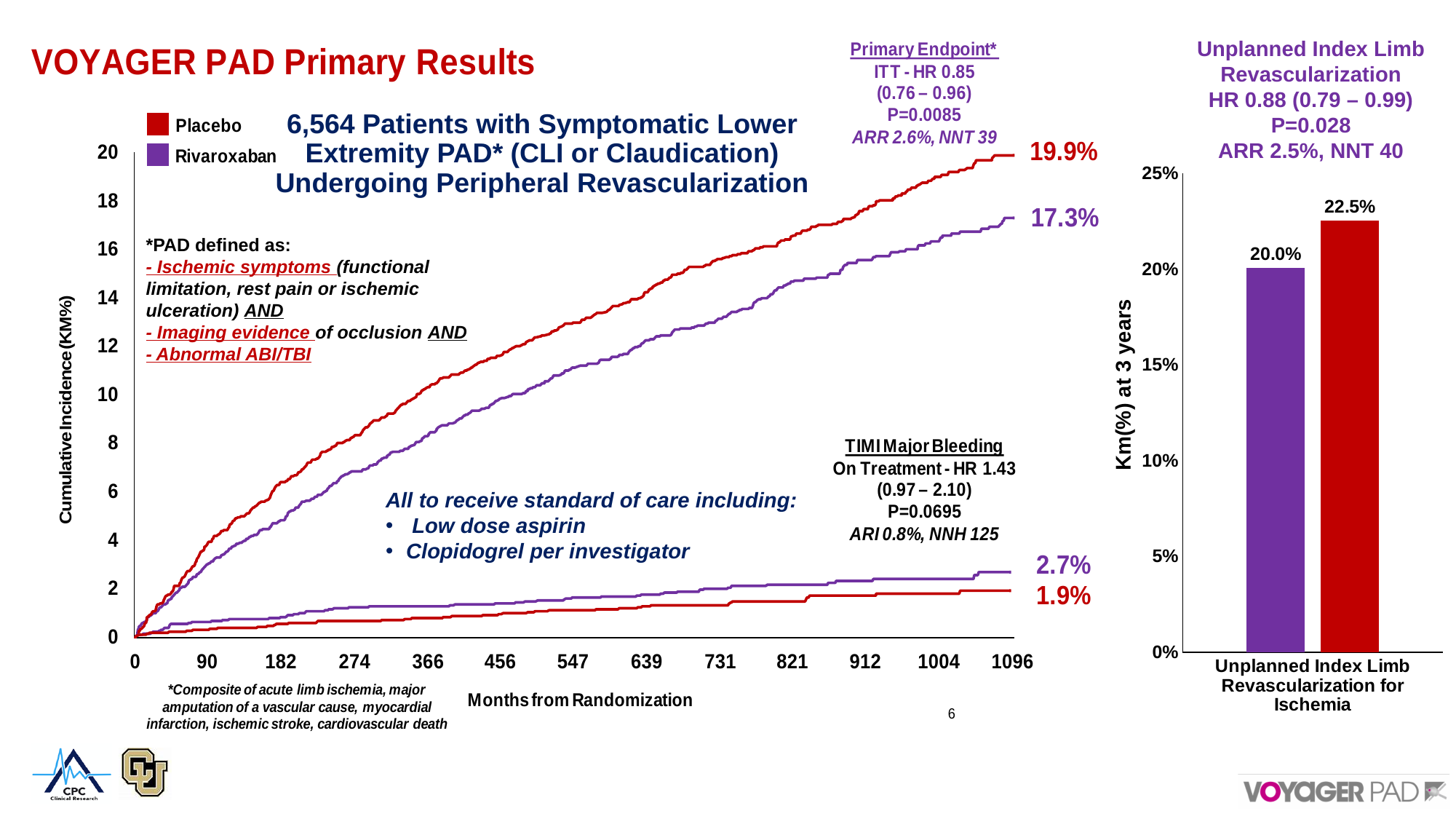
In the Kaplan-Meier chart on the left, what is the final cumulative incidence of the primary endpoint for Placebo? 19.9% In the Kaplan-Meier chart on the left, what is the difference between the final primary endpoint values for Placebo and Rivaroxaban? 2.6% What kind of chart is the Unplanned Index Limb Revascularization chart on the right? Bar chart In the Unplanned Index Limb Revascularization chart on the right, what is the KM% at 3 years for the Rivaroxaban (purple) bar? 20.0% In the Kaplan-Meier chart on the left, do the primary endpoint curves rise or fall over time from randomization? rise In the Kaplan-Meier chart on the left, which group has the higher final TIMI major bleeding value, Placebo or Rivaroxaban? Rivaroxaban In the Unplanned Index Limb Revascularization chart on the right, what is the KM% at 3 years for the Placebo (red) bar? 22.5% In the Kaplan-Meier chart on the left, how many series does the legend list? 2 In the Kaplan-Meier chart on the left, what is the final TIMI major bleeding value for Rivaroxaban? 2.7% In the Kaplan-Meier chart on the left, what is the final cumulative incidence of the primary endpoint for Rivaroxaban? 17.3% In the Kaplan-Meier chart on the left, what colour represents Placebo? Red In the Unplanned Index Limb Revascularization chart on the right, what is the difference between the red bar and the purple bar? 2.5%